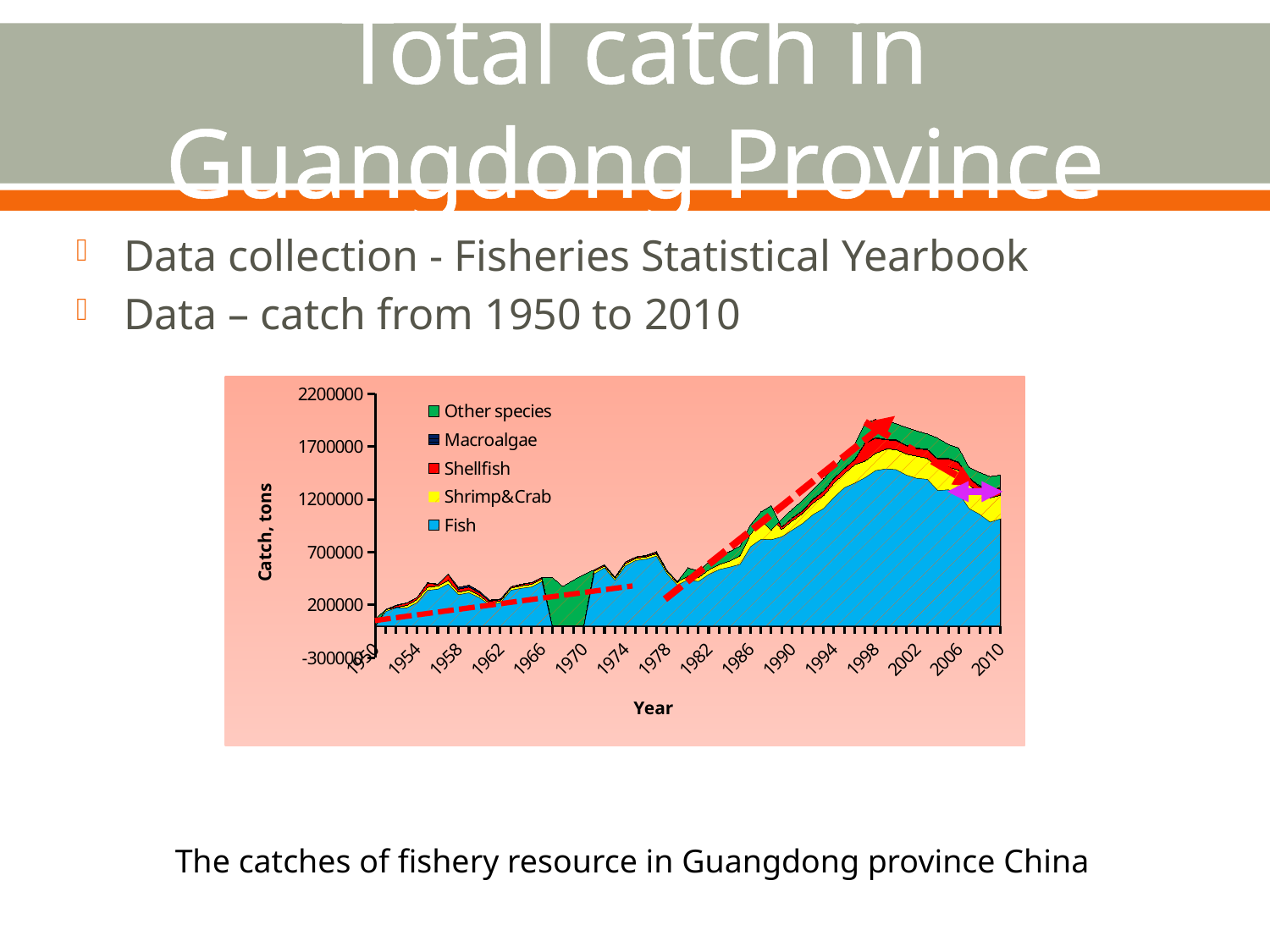
Which series is listed first in the chart's legend? Other species Is the total catch in 1994 greater or less than 1200000 tons? greater Is the total catch in 1998 greater or less than 1700000 tons? greater How many series does the chart's legend list? 5 What kind of chart is shown on the slide? Stacked area chart Is the total catch in 1950 greater or less than 200000 tons? less Which series makes up the largest part of the total catch in 2010, Fish or Shellfish? Fish What is the label of the vertical axis of the chart? Catch, tons Does the total catch rise or fall between 1998 and 2010? fall Does the total catch rise or fall between 1978 and 1998? rise